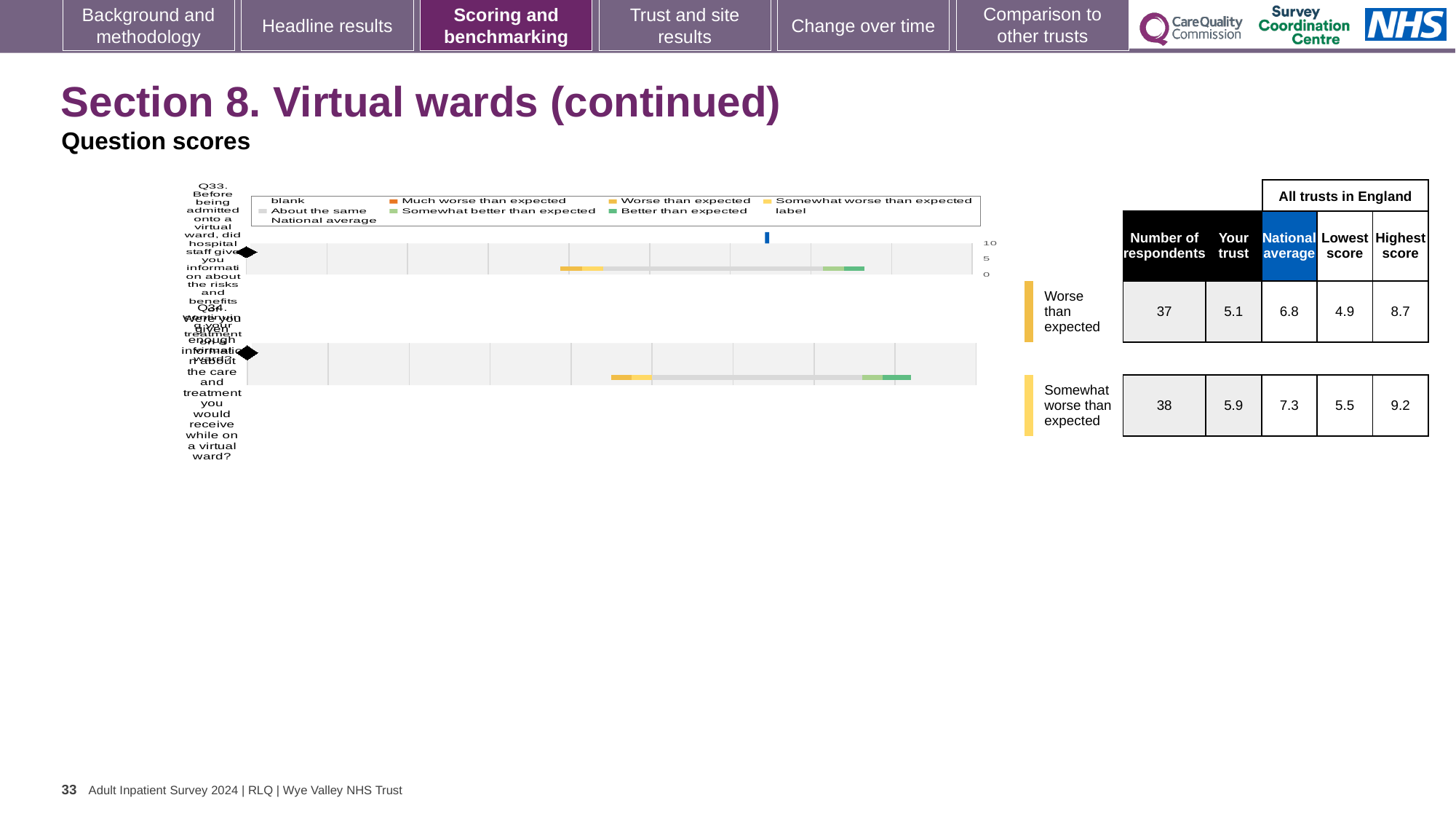
What benchmark rating is shown for Q34? Somewhat worse than expected What is the national average score for Q33? 6.8 How many questions (categories) are plotted in the chart? 2 What is the highest score among all trusts in England for Q33? 8.7 What is the 'Your trust' score for Q34 (enough information about care and treatment on a virtual ward)? 5.9 What is the national average score for Q34? 7.3 What kind of chart is shown on the slide? bar chart What is the difference between the national average and the trust's score for Q33? 1.7 What benchmark rating is shown for Q33? Worse than expected Which question has the higher 'Your trust' score, Q33 or Q34? Q34 What is the 'Your trust' score for Q33 (information about the risks and benefits of a virtual ward)? 5.1 How many respondents answered Q34? 38